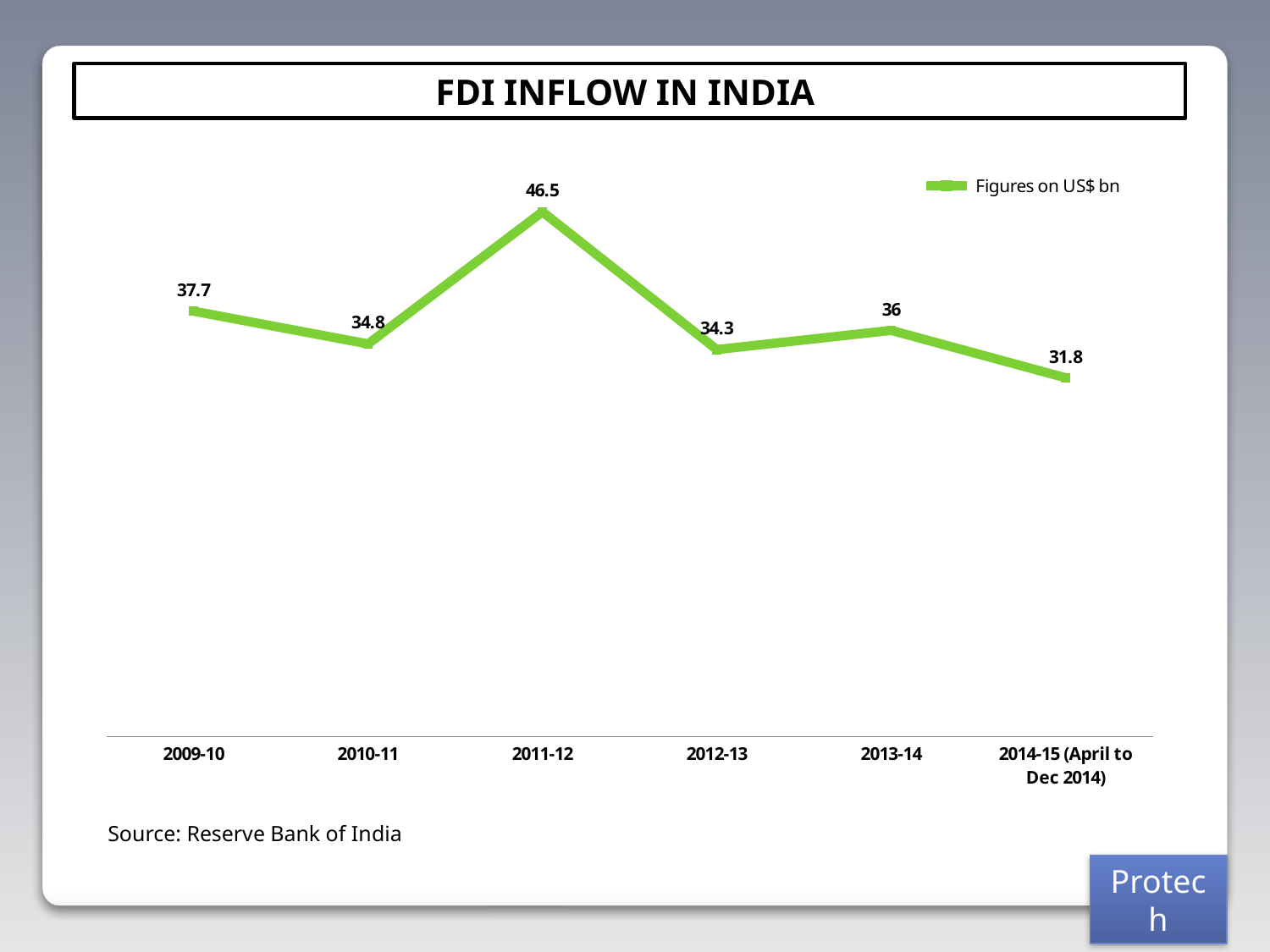
Which is larger, the FDI inflow in 2009-10 or in 2013-14? 2009-10 Which year has the highest FDI inflow? 2011-12 How many series does the legend list? 1 How many periods are plotted on the chart? 6 What is the FDI inflow value for 2014-15 (April to Dec 2014)? 31.8 What is the FDI inflow value for 2011-12? 46.5 What is the difference between the FDI inflow in 2011-12 and 2012-13? 12.2 Which period has the lowest FDI inflow? 2014-15 (April to Dec 2014) What kind of chart is shown on the slide? line chart What is the FDI inflow value for 2009-10? 37.7 Does the FDI inflow rise or fall from 2013-14 to 2014-15 (April to Dec 2014)? fall What is the title of the chart? FDI INFLOW IN INDIA